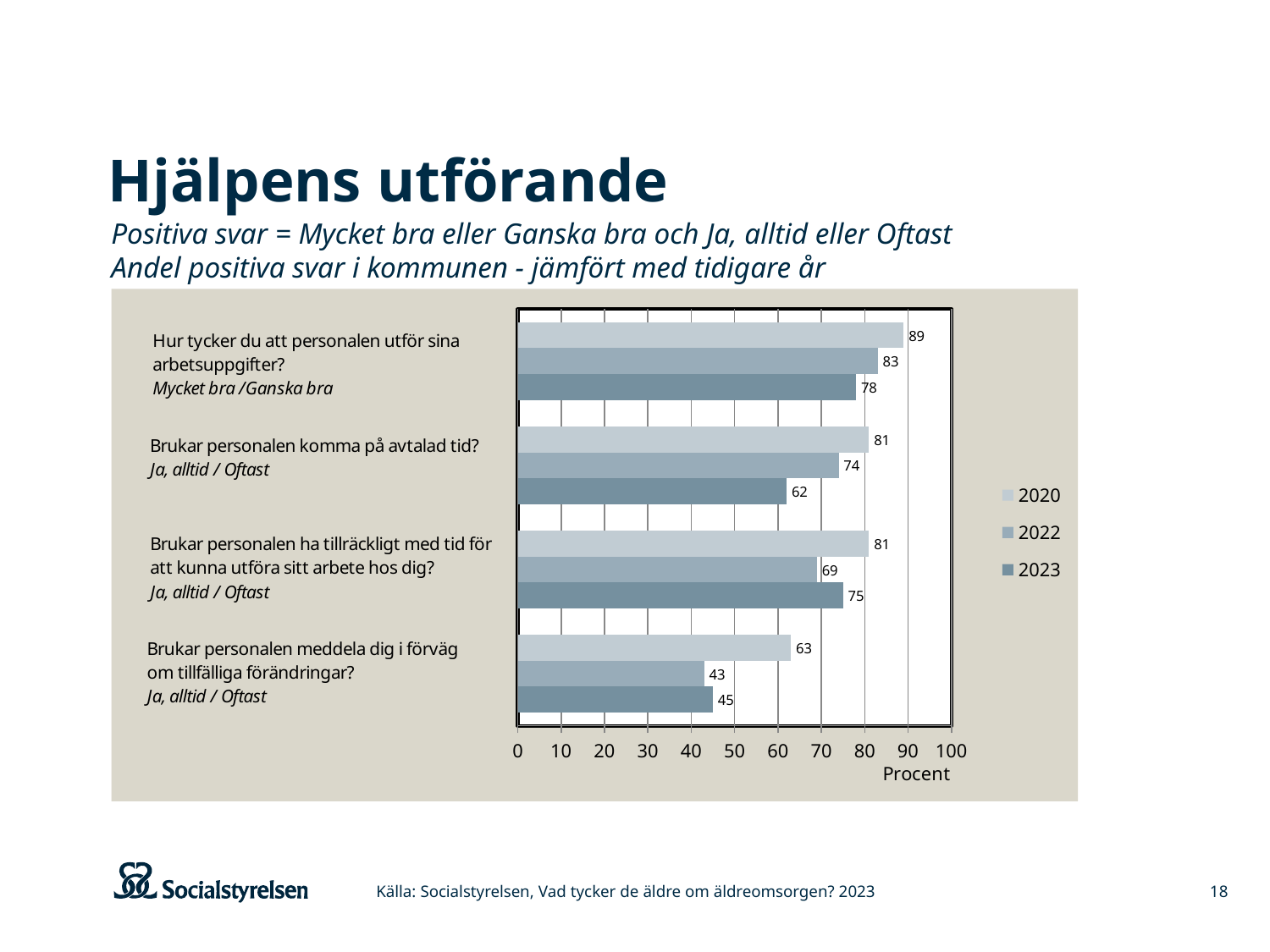
What is the 2023 value for "Brukar personalen komma på avtalad tid?"? 62 How many questions (categories) are shown in the chart? 4 What kind of chart is shown on the slide? Bar chart How many series does the legend list? 3 What is the 2020 value for "Hur tycker du att personalen utför sina arbetsuppgifter?"? 89 What is the label of the horizontal axis? Procent What is the difference between the 2020 and 2023 values for "Brukar personalen komma på avtalad tid?"? 19 Which question has the lowest 2023 value? Brukar personalen meddela dig i förväg om tillfälliga förändringar? What is the 2022 value for "Brukar personalen meddela dig i förväg om tillfälliga förändringar?"? 43 For "Brukar personalen ha tillräckligt med tid för att kunna utföra sitt arbete hos dig?", which is larger, the 2022 value or the 2023 value? 2023 Which question has the highest 2022 value? Hur tycker du att personalen utför sina arbetsuppgifter? Is the 2023 value for "Brukar personalen meddela dig i förväg om tillfälliga förändringar?" greater or less than 50? less